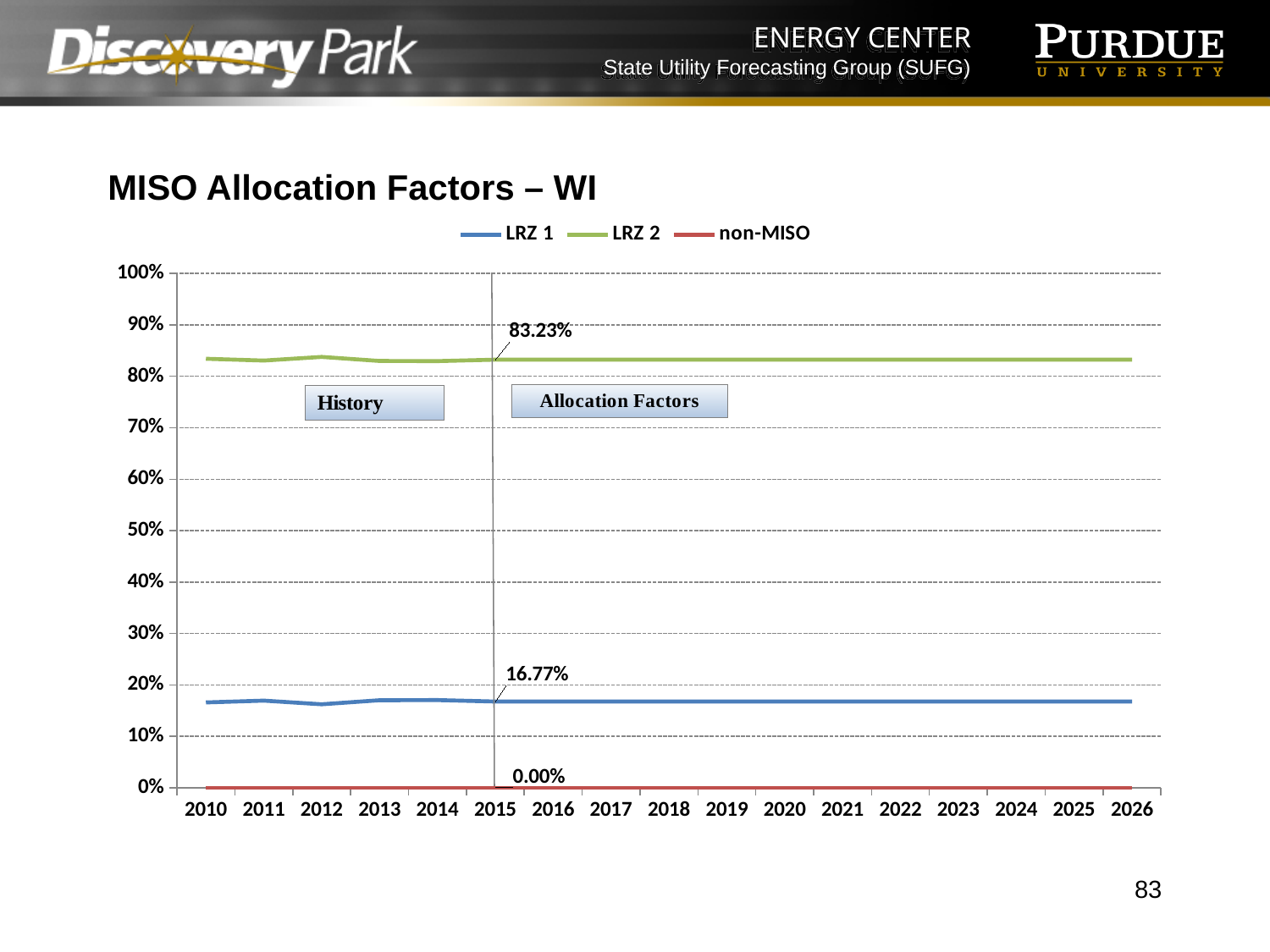
What is the value labeled for non-MISO in 2015? 0.00% How many series does the legend list? 3 Is the value for LRZ 2 in 2020 greater or less than 80%? greater How many years are shown on the x axis? 17 Is the value for LRZ 1 in 2010 greater or less than 20%? less Which series has the highest value in 2015? LRZ 2 What type of chart is shown on the slide? line chart What is the difference between the LRZ 2 and LRZ 1 values labeled in 2015? 66.46% What is the title of the chart? MISO Allocation Factors – WI What is the value labeled for LRZ 1 in 2015? 16.77% Which series has the lowest value in 2015? non-MISO What is the value labeled for LRZ 2 in 2015? 83.23%